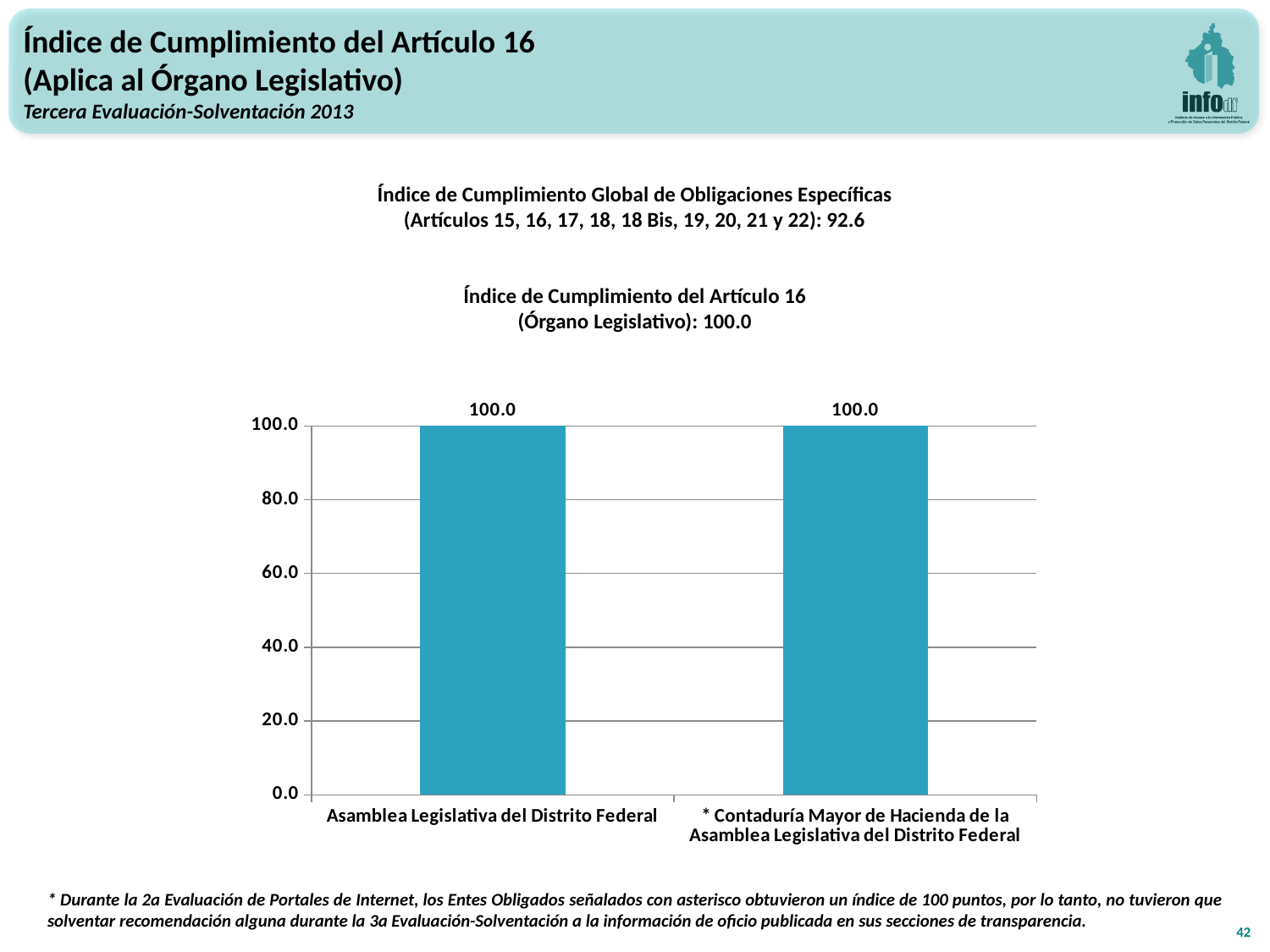
What is the difference between the values for Asamblea Legislativa del Distrito Federal and * Contaduría Mayor de Hacienda de la Asamblea Legislativa del Distrito Federal? 0.0 What is the value for Asamblea Legislativa del Distrito Federal? 100.0 What is the Índice de Cumplimiento del Artículo 16 (Órgano Legislativo) stated on the slide? 100.0 What is the value for * Contaduría Mayor de Hacienda de la Asamblea Legislativa del Distrito Federal? 100.0 How many categories are shown in the chart? 2 What kind of chart is shown on the slide? Bar chart Is the value for Asamblea Legislativa del Distrito Federal greater or less than 80.0? greater What is the highest value shown on the y axis? 100.0 Do the two bars in the chart have the same value? Yes Is the value for * Contaduría Mayor de Hacienda de la Asamblea Legislativa del Distrito Federal greater or less than 60.0? greater